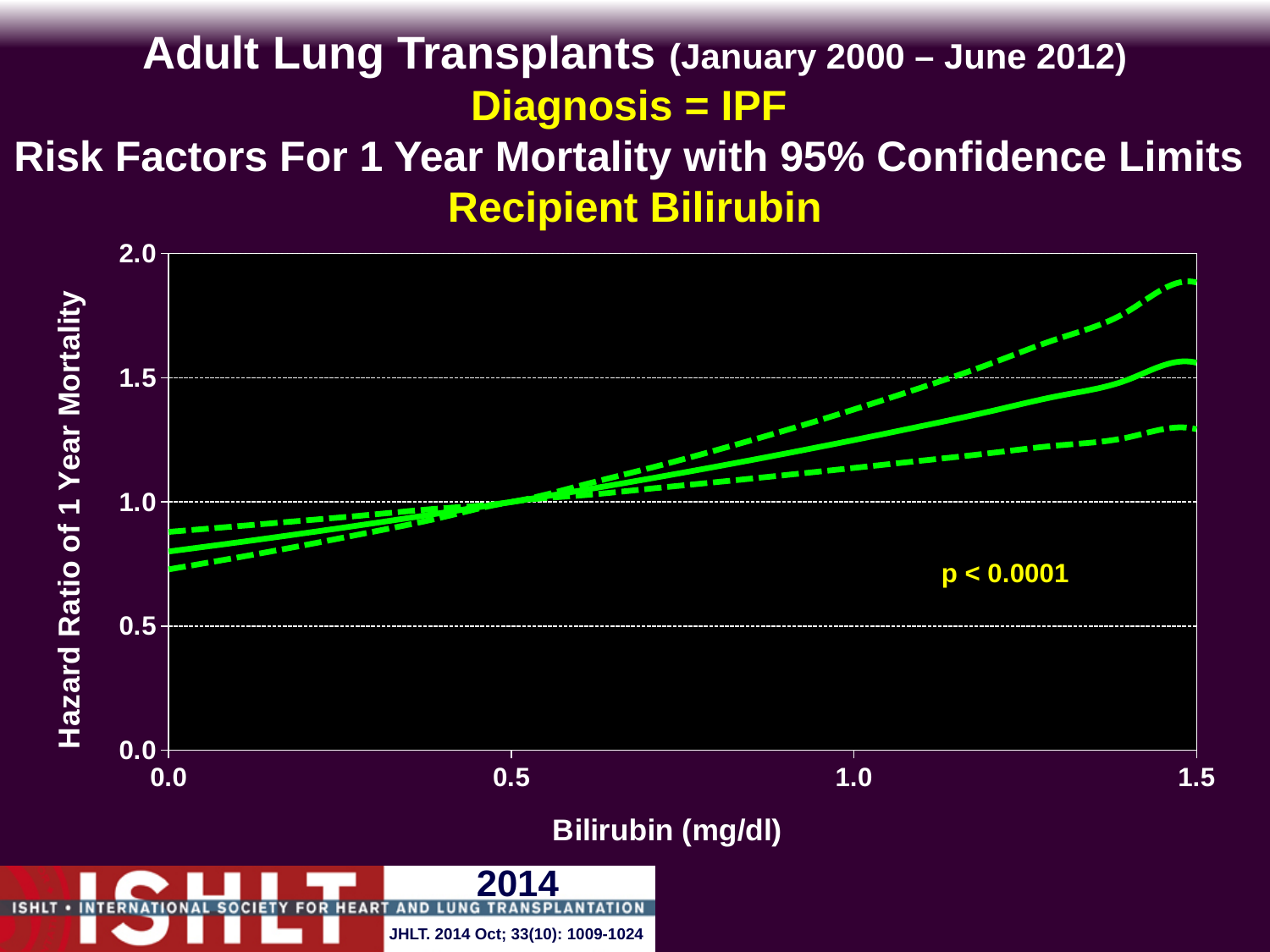
What is the label of the y axis? Hazard Ratio of 1 Year Mortality What p-value is printed on the chart? p < 0.0001 Is the hazard ratio (solid line) at a bilirubin of 0.0 mg/dl greater or less than 1.0? less Does the hazard ratio of 1 year mortality rise or fall as recipient bilirubin increases from 0.0 to 1.5 mg/dl? rise How many lines are plotted on the chart? 3 What kind of chart is shown on the slide? line chart What is the label of the x axis? Bilirubin (mg/dl) Is the upper 95% confidence limit (upper dashed line) at a bilirubin of 1.5 mg/dl greater or less than 1.5? greater Is the lower 95% confidence limit (lower dashed line) at a bilirubin of 0.0 mg/dl greater or less than 0.5? greater